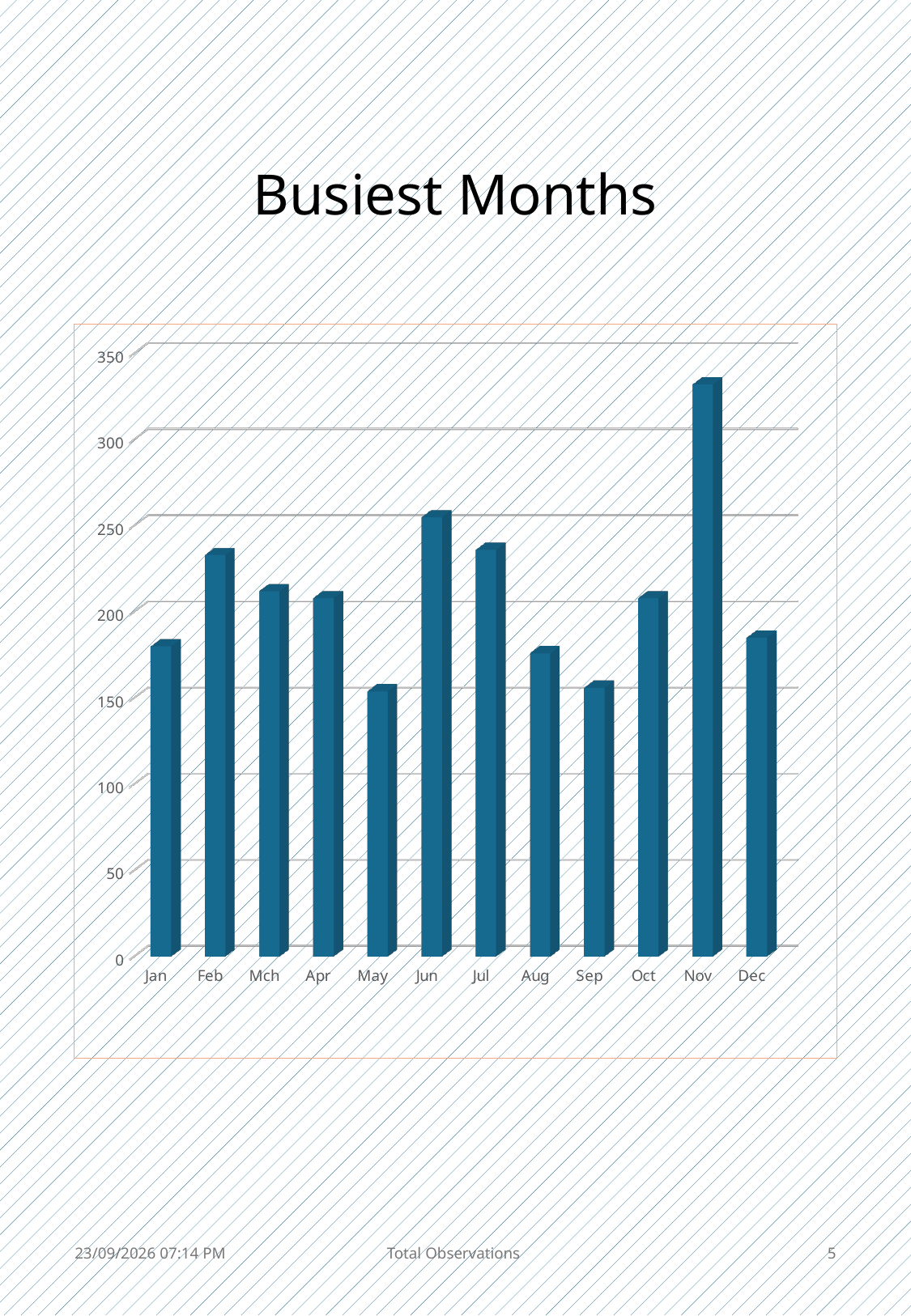
Which is larger, the value for Nov or the value for Jun? Nov Is the value for May greater or less than 200? less What kind of chart is shown on the slide? bar chart Which is larger, the value for Feb or the value for Jan? Feb Is the value for Jun greater or less than 200? greater What is the title of the slide? Busiest Months Which is larger, the value for Jul or the value for Aug? Jul How many months are shown on the x axis of the chart? 12 Is the value for Nov greater or less than 300? greater Which month has the highest value in the chart? Nov